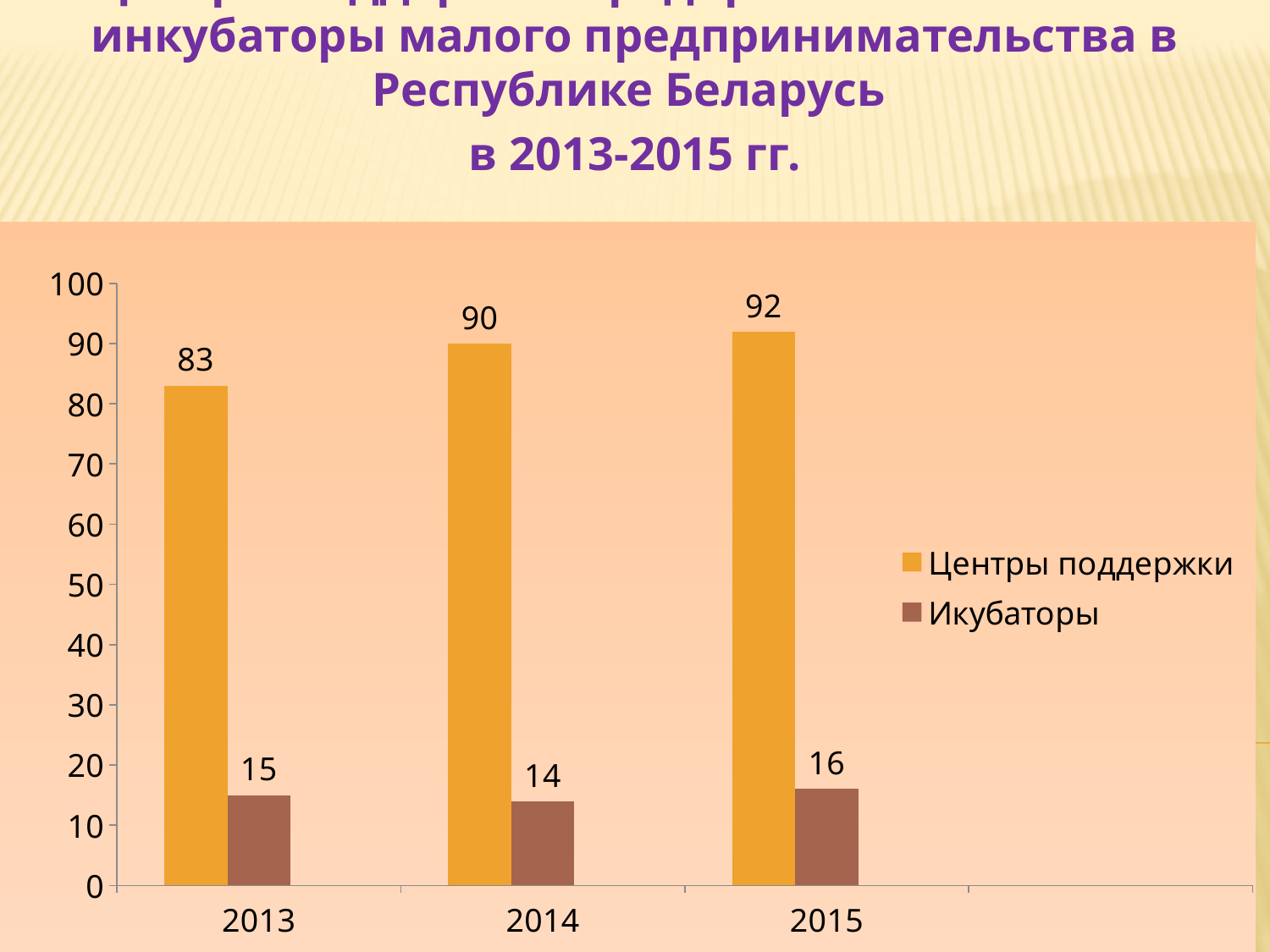
How many series does the legend list? 2 What colour are the bars for Центры поддержки? orange Which is larger: Икубаторы in 2015 or Икубаторы in 2013? Икубаторы in 2015 In which year is the value for Центры поддержки highest? 2015 How many years are shown on the x axis? 3 In which year is the value for Икубаторы lowest? 2014 What is the value for Центры поддержки in 2015? 92 Do the values for Центры поддержки rise or fall from 2013 to 2015? rise What is the value for Центры поддержки in 2013? 83 What is the value for Икубаторы in 2014? 14 What kind of chart is shown on the slide? bar chart What is the difference between the Центры поддержки values for 2014 and 2013? 7